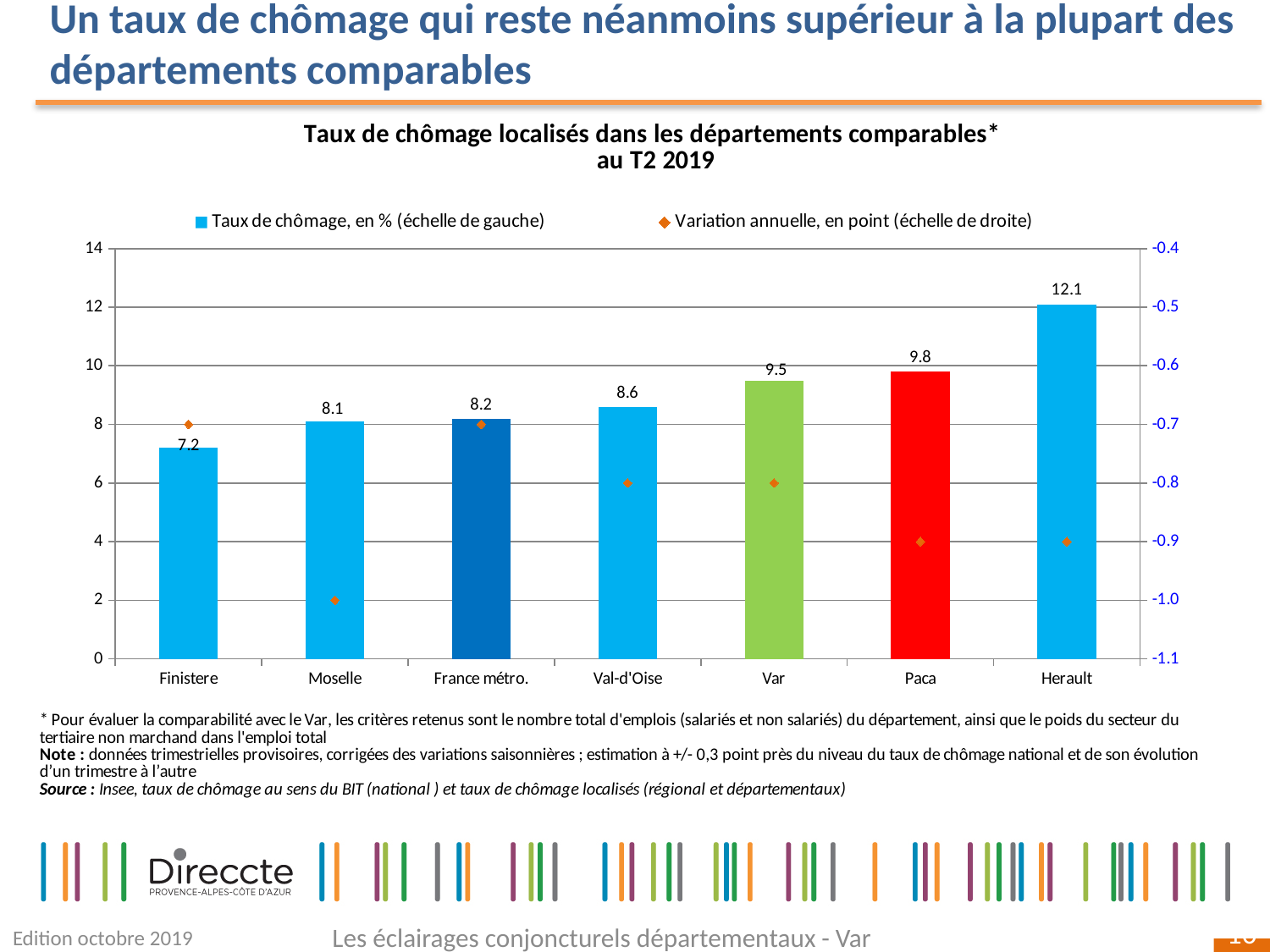
What kind of chart is used to show the unemployment rates? Bar chart How many series does the legend list? 2 Which department has the highest unemployment rate in the chart? Herault Which department has the lowest unemployment rate in the chart? Finistere Which has a higher unemployment rate, Var or Val-d'Oise? Var What is the unemployment rate (taux de chômage) shown for Var? 9.5 What is the unemployment rate (taux de chômage) shown for Herault? 12.1 What is the annual variation (variation annuelle, right axis) shown for Moselle? -1.0 What is the unemployment rate (taux de chômage) shown for France métro.? 8.2 How many departments/categories are shown on the x axis? 7 Do the unemployment rate bars rise or fall from Finistere to Herault along the x axis? Rise What is the difference between the unemployment rates of Herault and Finistere? 4.9